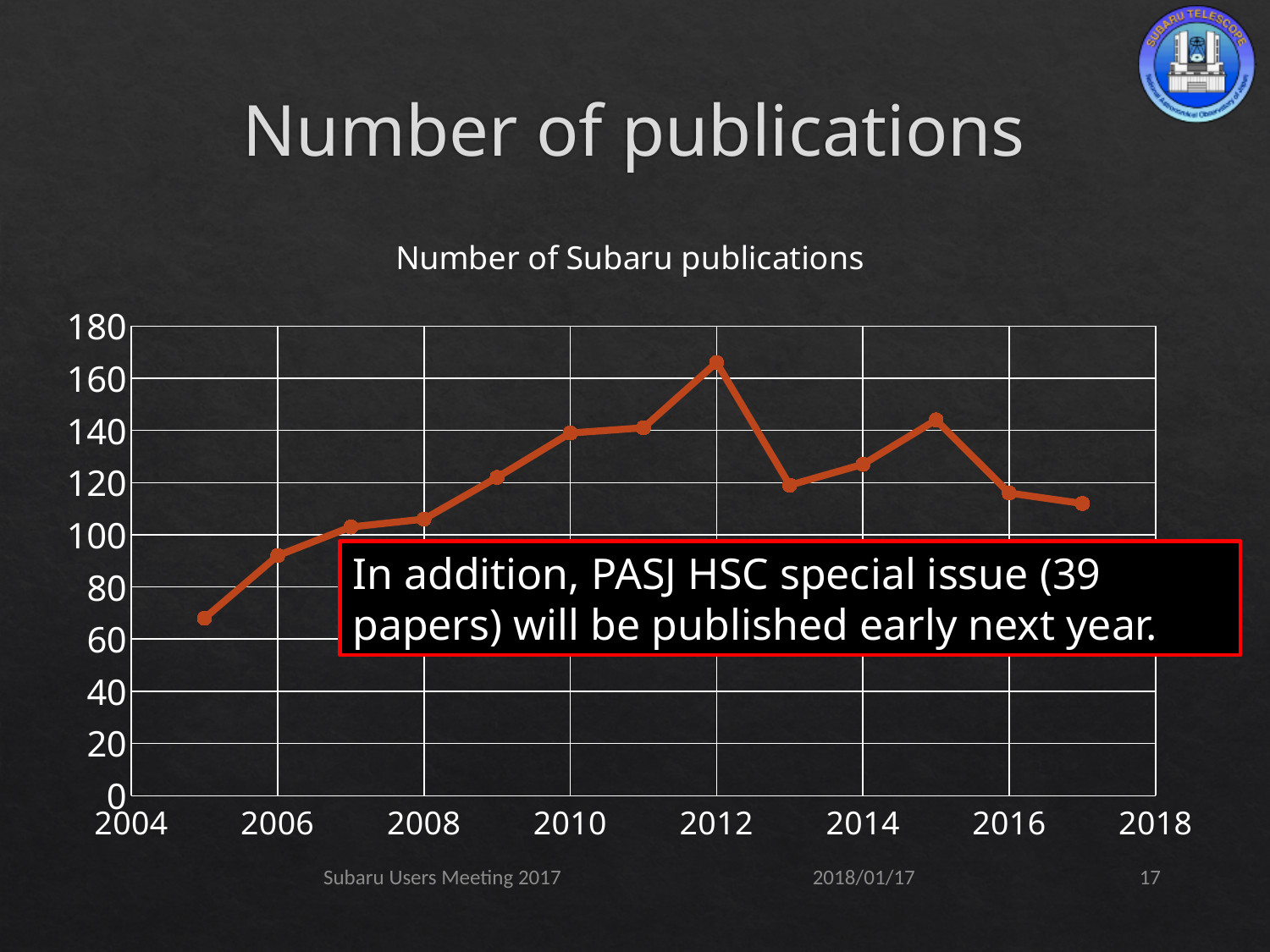
What is the title of the chart? Number of Subaru publications Do the values rise or fall from 2005 to 2012? rise In which year is the number of publications lowest? 2005 Which year has more publications, 2013 or 2014? 2014 How many data points are plotted on the line? 13 Is the value for 2012 greater or less than 160? greater Is the value for 2005 greater or less than 80? less In which year is the number of publications highest? 2012 What kind of chart is shown on the slide? line chart Which year has more publications, 2012 or 2015? 2012